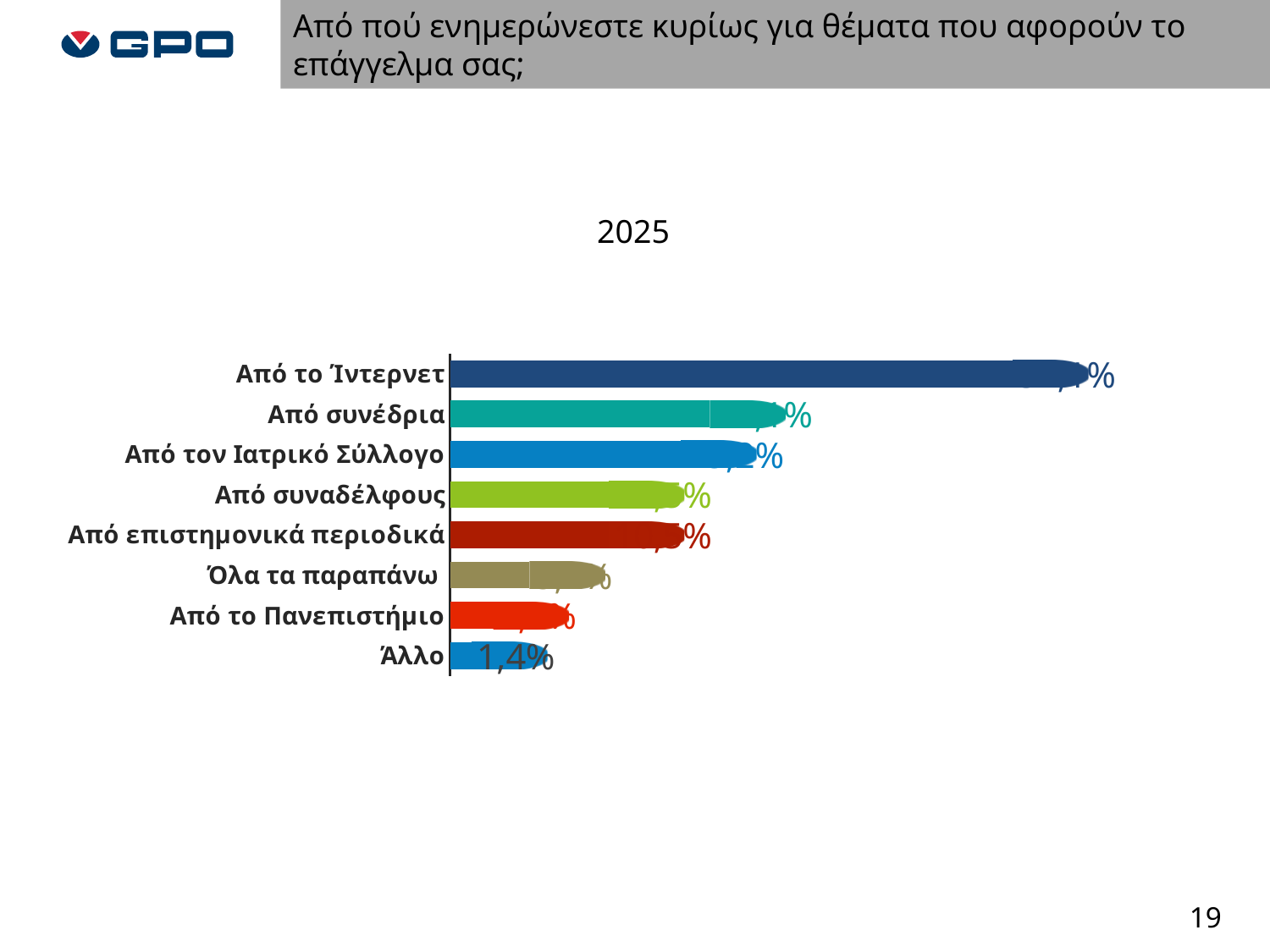
Which category is listed at the top of the chart? Από το Ίντερνετ What is the value shown for Άλλο? 1,4% What kind of chart is shown on the slide? bar chart How many categories are plotted in the chart? 8 Which is larger, the value for Όλα τα παραπάνω or the value for Από το Πανεπιστήμιο? Όλα τα παραπάνω Which is larger, the value for Από συνέδρια or the value for Από συναδέλφους? Από συνέδρια Which is larger, the value for Από τον Ιατρικό Σύλλογο or the value for Από επιστημονικά περιοδικά? Από τον Ιατρικό Σύλλογο What is the title shown above the chart? 2025 Which category has the highest value in the chart? Από το Ίντερνετ Which category has the lowest value in the chart? Άλλο